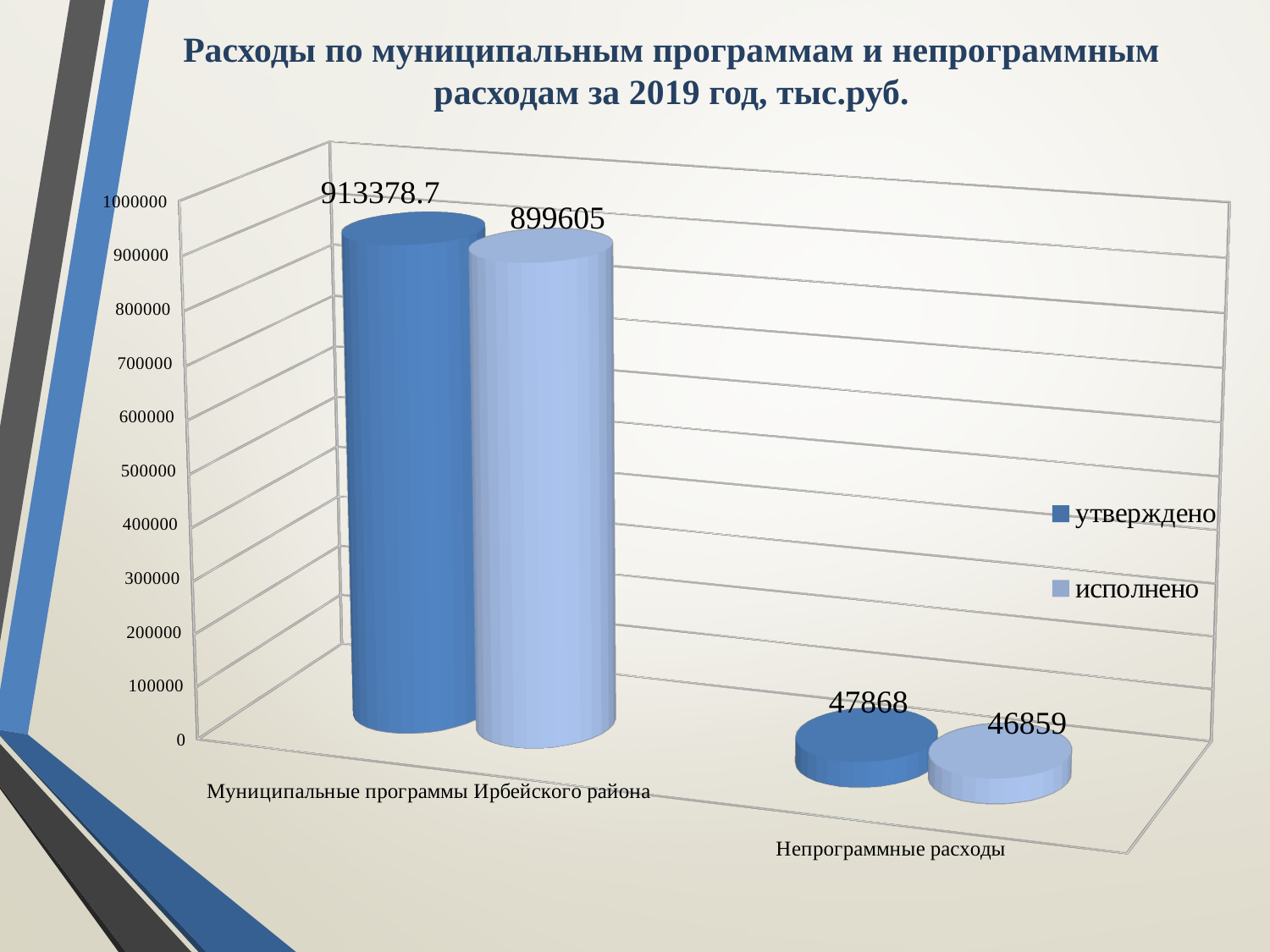
What is the approved (утверждено) value for Непрограммные расходы? 47868 What is the difference between the approved and executed values for Муниципальные программы Ирбейского района? 13773.7 Which category has the lowest executed (исполнено) value? Непрограммные расходы How many series does the legend list? 2 What kind of chart is shown on the slide? Bar chart What is the difference between the approved and executed values for Непрограммные расходы? 1009 What is the executed (исполнено) value for Муниципальные программы Ирбейского района? 899605 How many categories are shown on the x axis? 2 Which category has the highest approved (утверждено) value? Муниципальные программы Ирбейского района Which is larger: the approved value for Муниципальные программы Ирбейского района or the approved value for Непрограммные расходы? Муниципальные программы Ирбейского района What is the approved (утверждено) value for Муниципальные программы Ирбейского района? 913378.7 What is the executed (исполнено) value for Непрограммные расходы? 46859